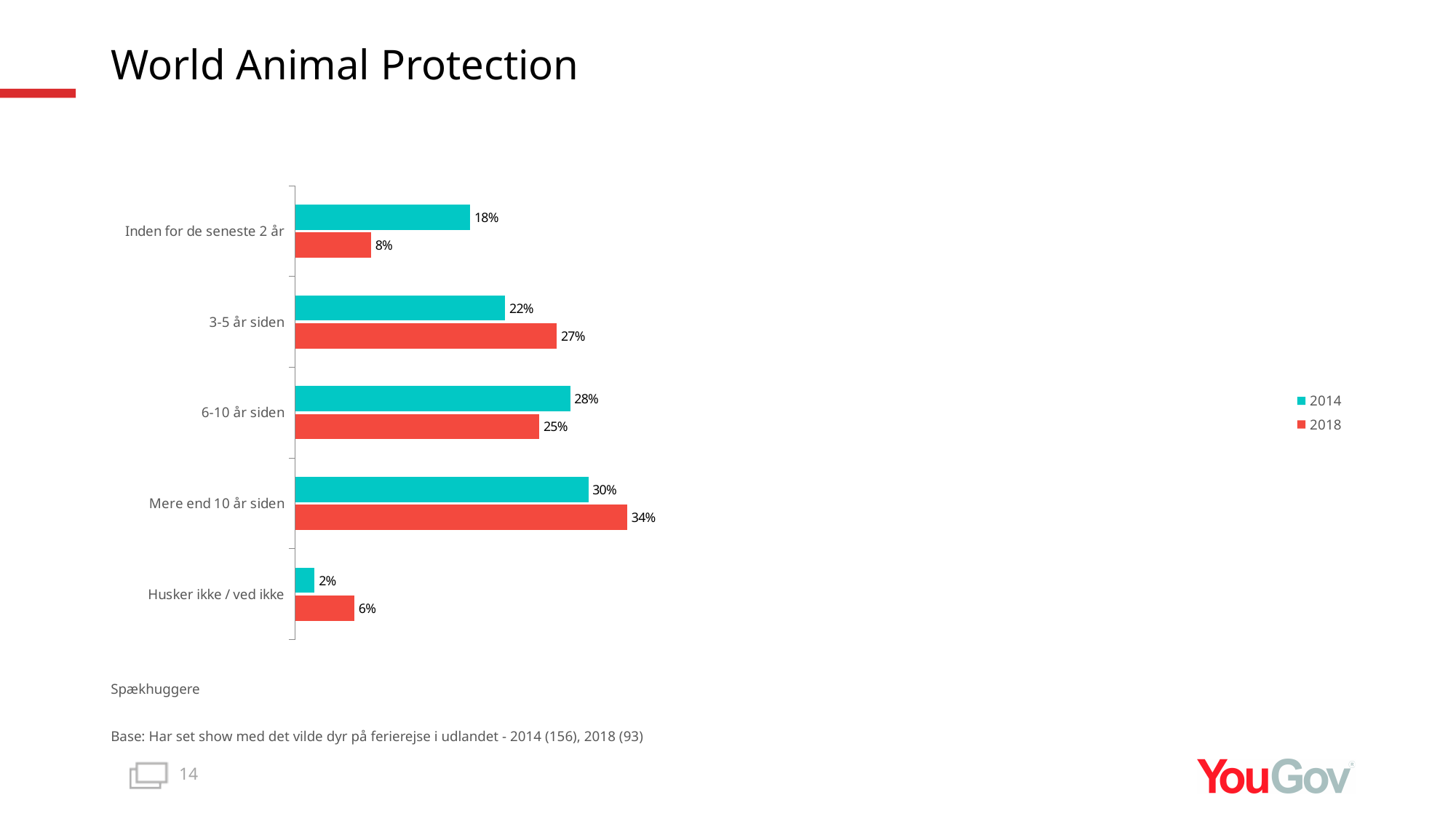
What is the 2014 value for "Inden for de seneste 2 år"? 18% How many categories are shown on the chart? 5 What is the difference between the 2014 and 2018 values for "Inden for de seneste 2 år"? 10% Which category has the highest 2014 value? Mere end 10 år siden How many series does the legend list? 2 Which category has the lowest 2018 value? Husker ikke / ved ikke What is the 2018 value for "Mere end 10 år siden"? 34% Which series is shown in red? 2018 What is the 2018 value for "Husker ikke / ved ikke"? 6% Which is larger for "3-5 år siden": the 2014 value or the 2018 value? 2018 What is the difference between the 2018 and 2014 values for "Mere end 10 år siden"? 4% What kind of chart is shown on the slide? Bar chart